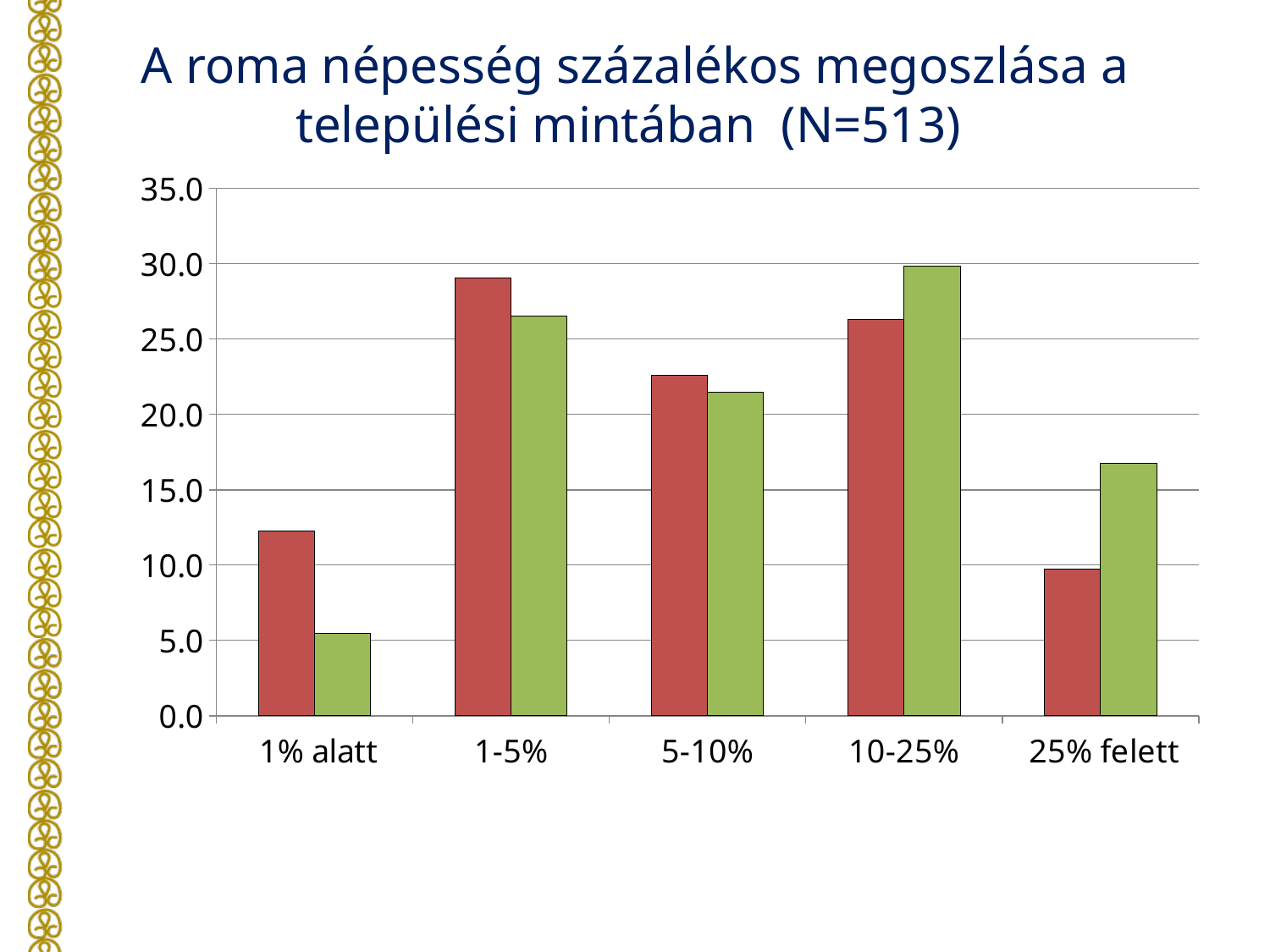
For which category is the red bar the highest? 1-5% For which category is the green bar the highest? 10-25% Is the value of the red bar for 1% alatt greater or less than 10.0? greater Is the value of the green bar for 1% alatt greater or less than 10.0? less In the 25% felett category, which bar is taller, the red or the green? green What is the title of the chart? A roma népesség százalékos megoszlása a települési mintában (N=513) For which category is the red bar the lowest? 25% felett How many categories are shown on the x axis? 5 Is the value of the green bar for 25% felett greater or less than 15.0? greater What kind of chart is shown on the slide? bar chart For which category is the green bar the lowest? 1% alatt In the 1% alatt category, which bar is taller, the red or the green? red